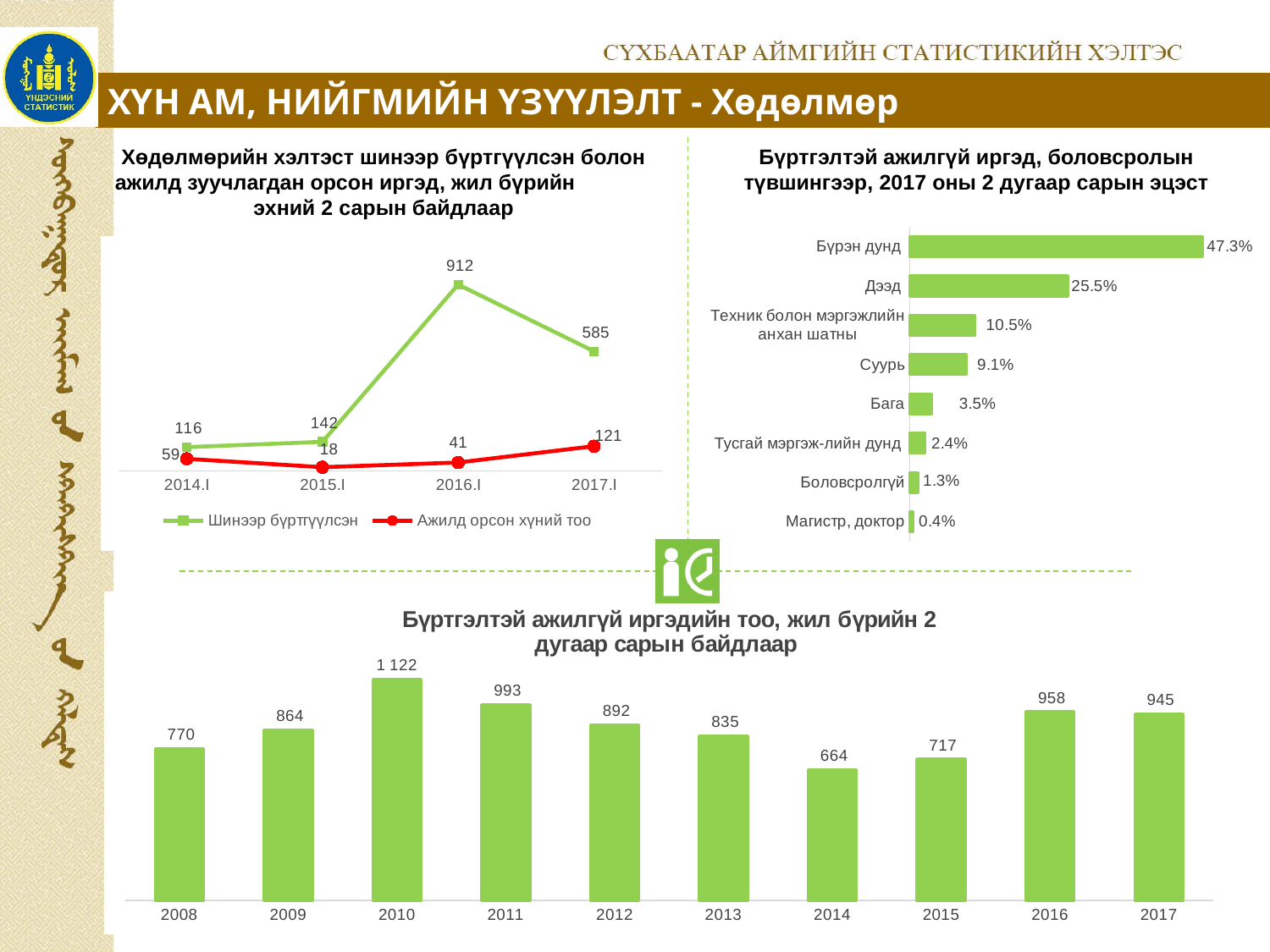
In the top-right bar chart, what is the value for 'Дээд'? 25.5% In the top-right bar chart, how many categories are shown? 8 In the bottom bar chart, which year has the lowest value? 2014 In the top-left line chart, what is the value for 'Шинээр бүртгүүлсэн' in 2016.I? 912 In the top-right bar chart, which category has the highest value? Бүрэн дунд In the top-left line chart, what is the difference between 'Шинээр бүртгүүлсэн' and 'Ажилд орсон хүний тоо' in 2017.I? 464 In the top-right bar chart, which is larger: 'Суурь' or 'Бага'? Суурь In the top-left line chart, what is the value for 'Ажилд орсон хүний тоо' in 2017.I? 121 In the bottom bar chart, what is the value for 2010? 1 122 In the top-left line chart, how many series does the legend list? 2 What type of chart is the bottom chart? bar chart In the top-left line chart, in which period is 'Ажилд орсон хүний тоо' lowest? 2015.I